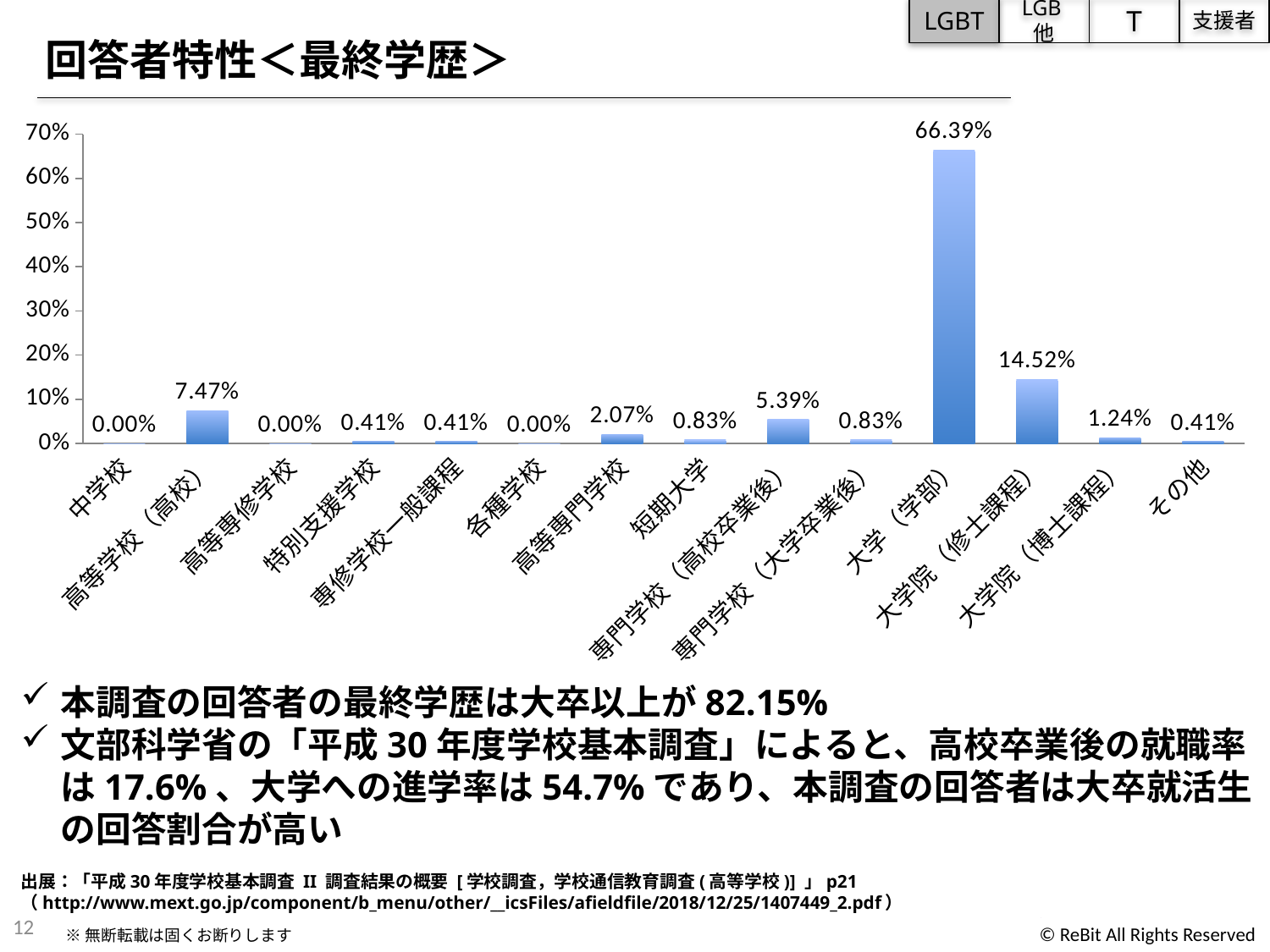
What is the difference between the values for 大学（学部） and 大学院（修士課程）? 51.87% What is the value for 高等学校（高校）? 7.47% What is the value for 高等専門学校? 2.07% What is the value for 大学院（修士課程）? 14.52% How many categories are shown on the x axis? 14 What is the title of the slide? 回答者特性＜最終学歴＞ What kind of chart is shown on the slide? bar chart Which category has the highest value? 大学（学部） Which is larger, the value for 高等学校（高校） or the value for 専門学校（高校卒業後）? 高等学校（高校） Is the value for 大学（学部） greater or less than 60%? greater What is the value for 大学（学部）? 66.39% What is the value for 専門学校（高校卒業後）? 5.39%